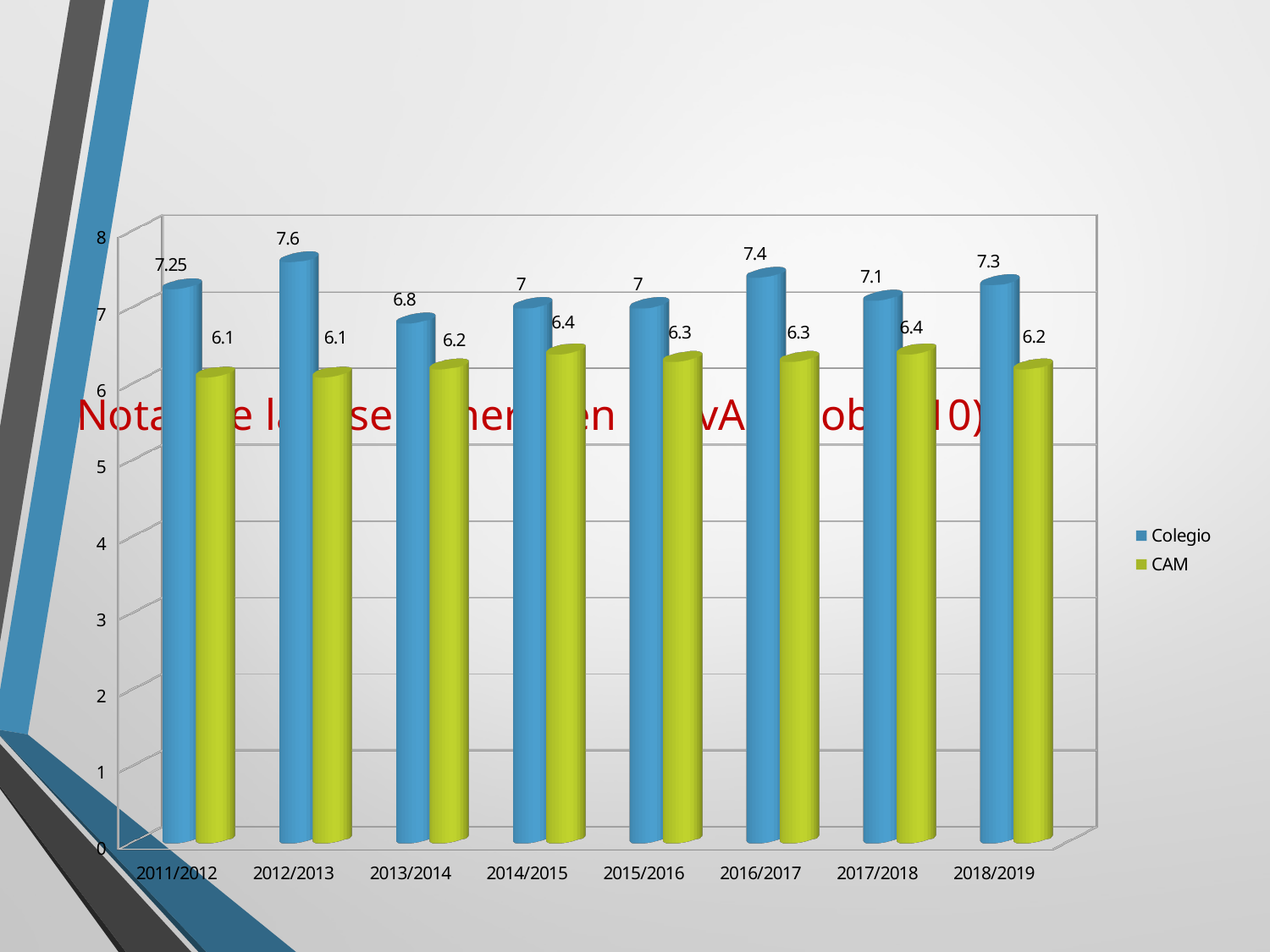
What is the difference between the Colegio and CAM values in 2016/2017? 1.1 What is the difference between the Colegio values for 2012/2013 and 2013/2014? 0.8 Is the CAM value for 2015/2016 greater or less than 7? less In which year is the Colegio value highest? 2012/2013 How many series does the legend list? 2 How many academic years are shown on the x axis? 8 What is the CAM value for 2014/2015? 6.4 What is the Colegio value for 2018/2019? 7.3 In which year is the Colegio value lowest? 2013/2014 What is the Colegio value for 2011/2012? 7.25 Which is larger in 2017/2018, the Colegio value or the CAM value? Colegio What kind of chart is shown on the slide? bar chart